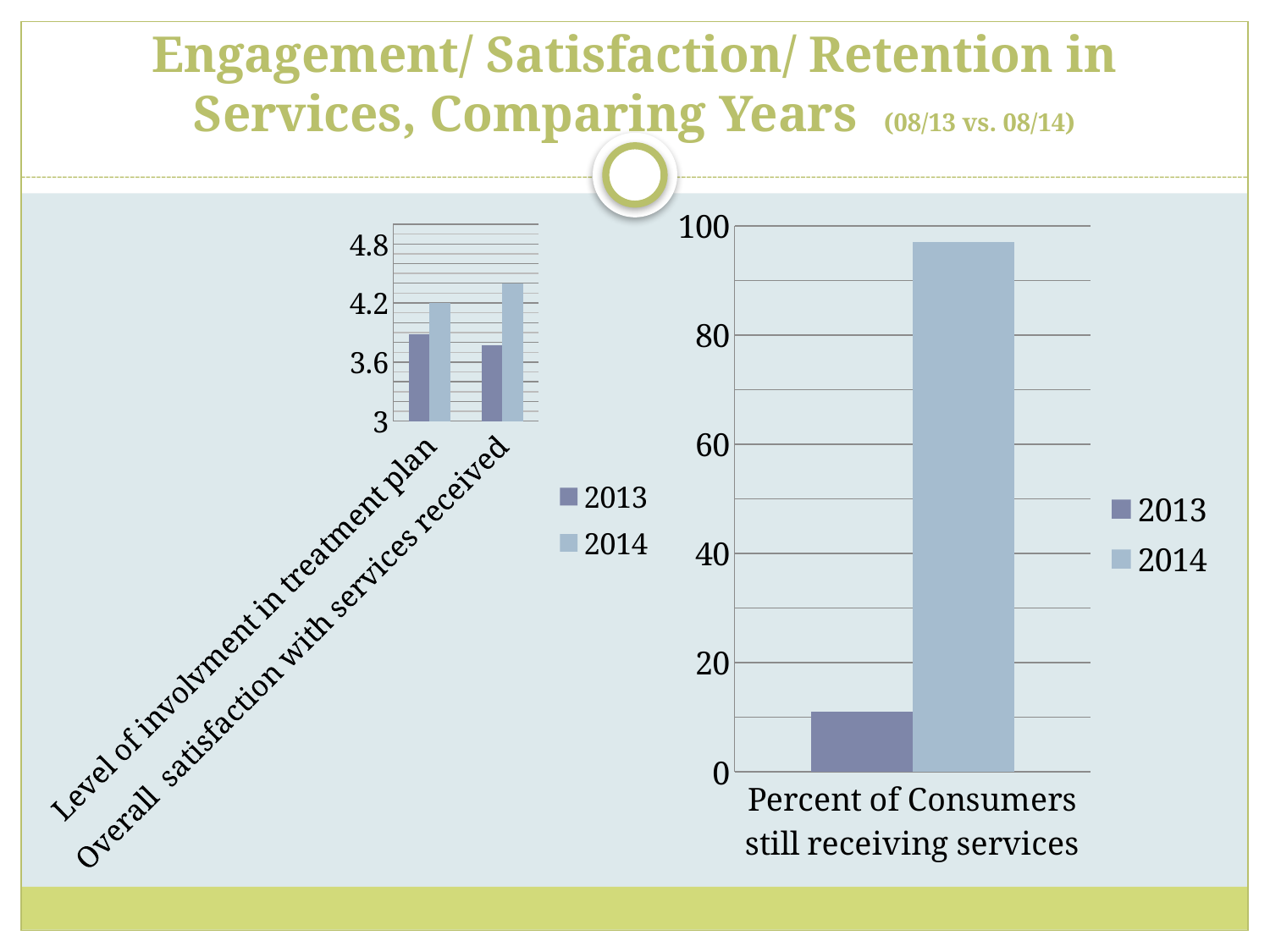
In the left chart, which year has the larger value for Level of involvement in treatment plan, 2013 or 2014? 2014 In the right chart, which year has the larger value for Percent of Consumers still receiving services, 2013 or 2014? 2014 What is the category label on the x axis of the right chart? Percent of Consumers still receiving services In the left chart, is the 2013 value for Level of involvement in treatment plan greater or less than 3.6? greater In the left chart, is the 2014 value for Overall satisfaction with services received greater or less than 4.2? greater In the right chart, is the 2013 value for Percent of Consumers still receiving services greater or less than 20? less In the left chart, which year has the larger value for Overall satisfaction with services received, 2013 or 2014? 2014 How many series does the legend of the left chart list? 2 How many categories are shown on the x axis of the left chart? 2 What kind of chart is the chart on the right of the slide? bar chart